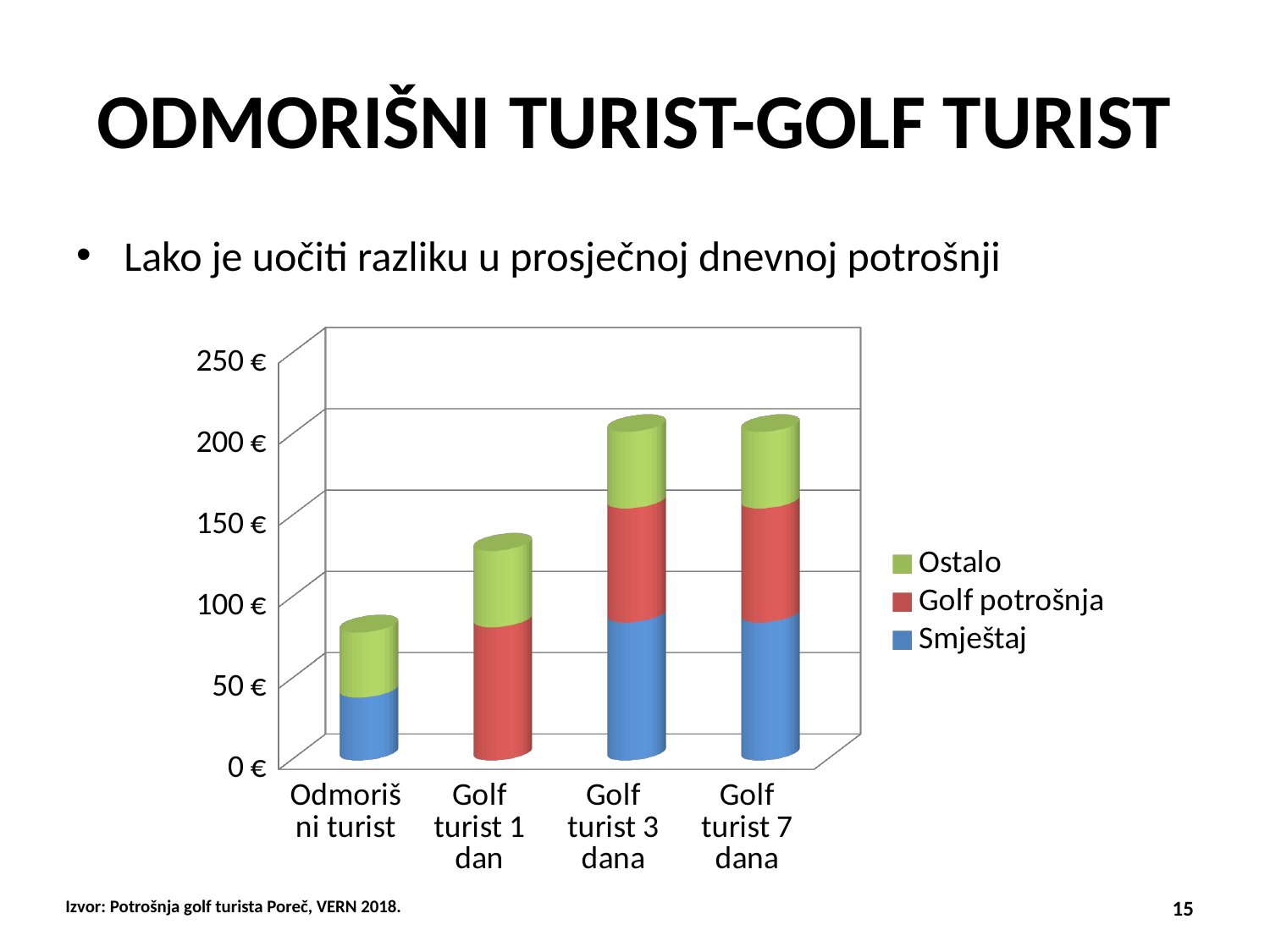
Is the total bar for Golf turist 7 dana greater or less than 150 €? greater Which category's bar has no Smještaj segment? Golf turist 1 dan What kind of chart is shown on the slide? bar chart Is the total bar for Golf turist 1 dan greater or less than 100 €? greater Which series is shown in green in the chart legend? Ostalo How many series does the chart legend list? 3 Is the total bar for Golf turist 3 dana greater or less than 150 €? greater Which category has the lowest total bar in the chart? Odmorišni turist Which has a larger total bar, Odmorišni turist or Golf turist 1 dan? Golf turist 1 dan How many categories are shown on the x axis of the chart? 4